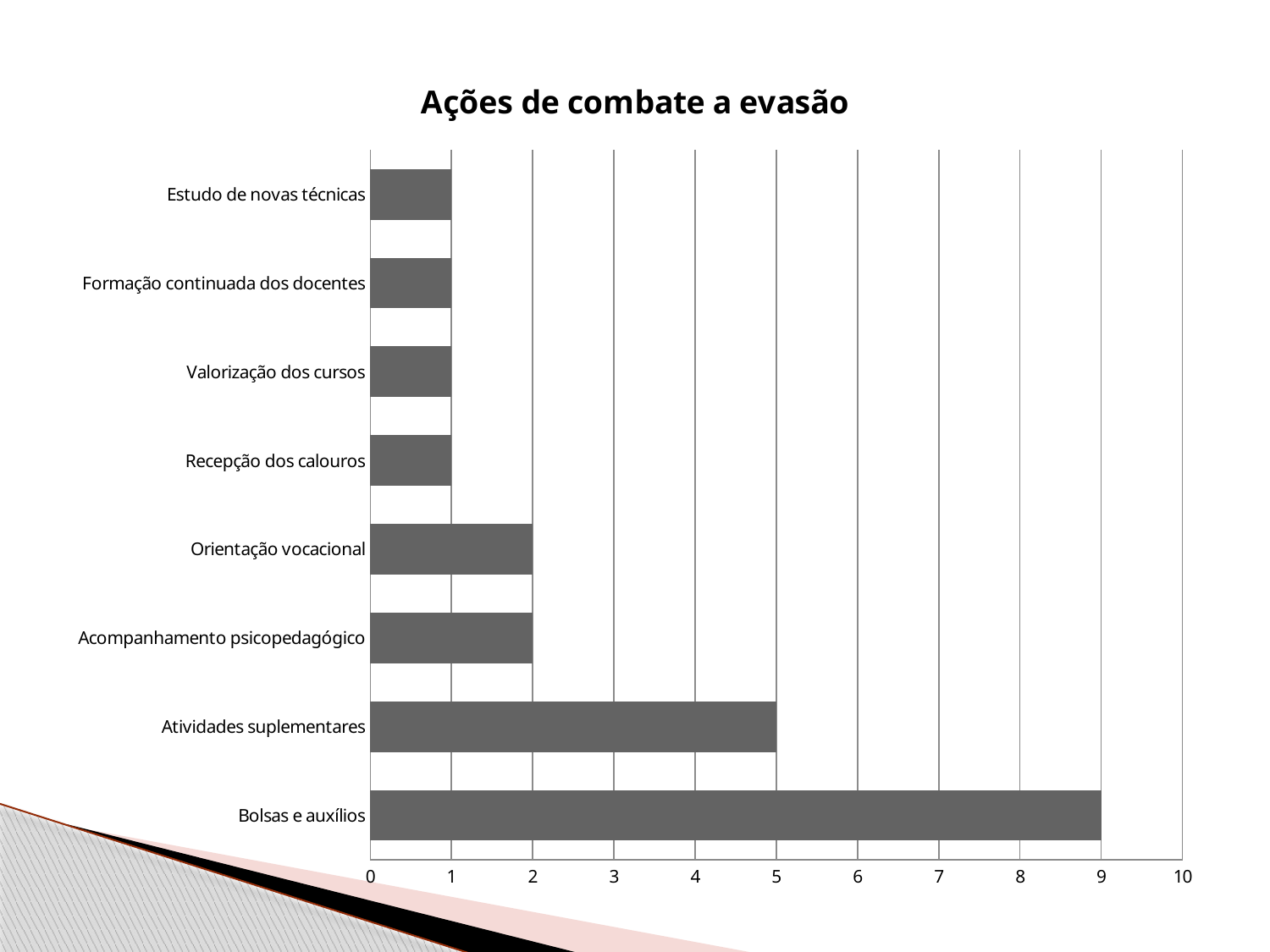
Which is larger, the value for Atividades suplementares or the value for Orientação vocacional? Atividades suplementares Which category has the highest value? Bolsas e auxílios What is the difference between the values for Atividades suplementares and Acompanhamento psicopedagógico? 3 What is the value for Recepção dos calouros? 1 What kind of chart is shown on the slide? Bar chart What is the value for Bolsas e auxílios? 9 What is the title of the chart? Ações de combate a evasão What is the difference between the values for Bolsas e auxílios and Atividades suplementares? 4 How many categories are shown in the chart? 8 What is the value for Orientação vocacional? 2 Is the value for Bolsas e auxílios greater or less than 8? greater What is the value for Atividades suplementares? 5